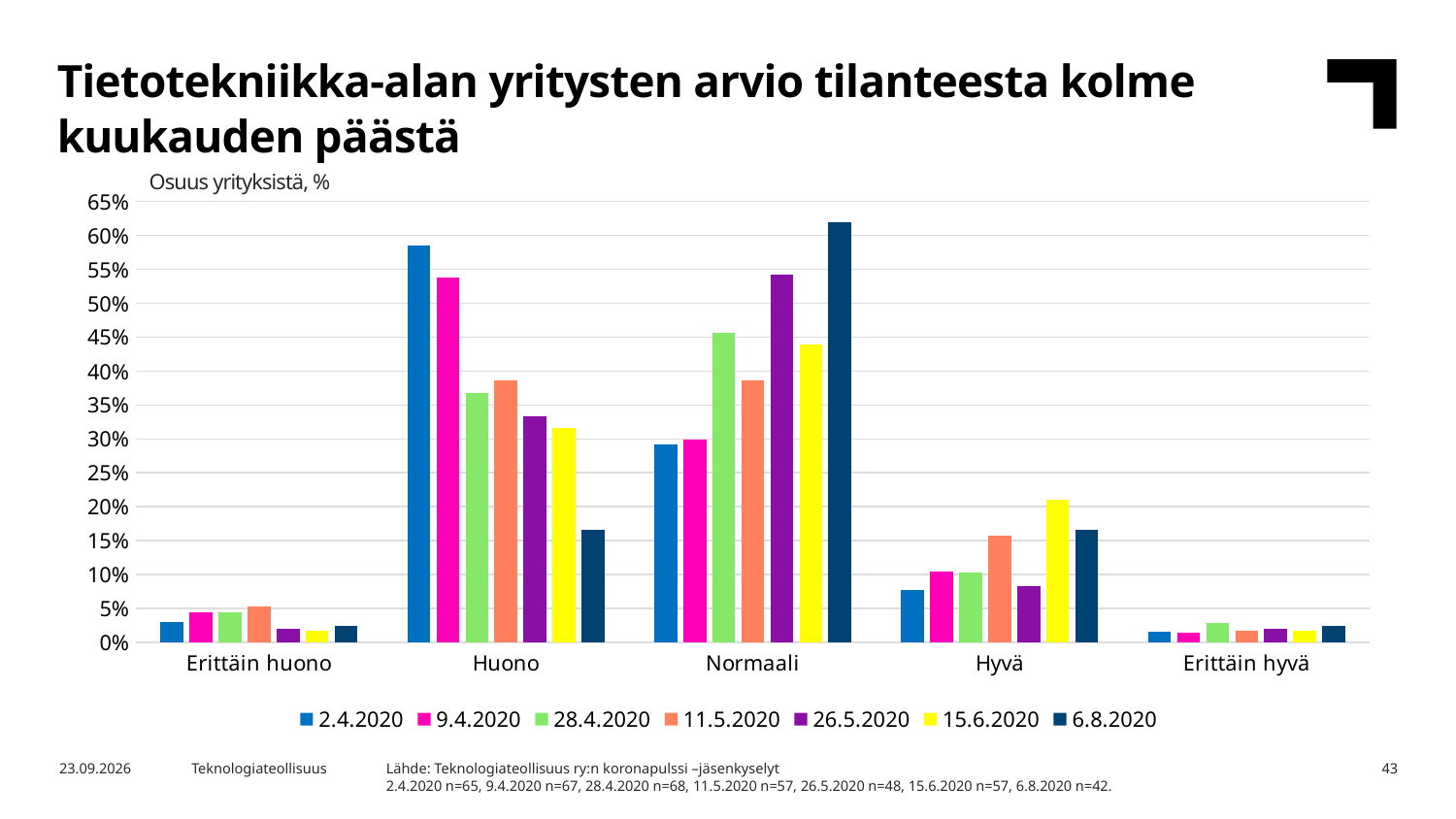
Is the value for 6.8.2020 in the Normaali category greater or less than 60%? greater What label is shown above the vertical axis? Osuus yrityksistä, % Is the value for 2.4.2020 in the Huono category greater or less than 55%? greater How many categories are shown on the x axis? 5 Which series has the lowest bar in the Huono category? 6.8.2020 In the Erittäin huono category, which is larger: the 11.5.2020 bar or the 26.5.2020 bar? 11.5.2020 How many series does the legend list? 7 Which series has the highest bar in the Huono category? 2.4.2020 Which category has the highest bar for the 6.8.2020 series? Normaali Is the value for 15.6.2020 in the Hyvä category greater or less than 15%? greater What kind of chart is shown on the slide? bar chart In the Hyvä category, which is larger: the 15.6.2020 bar or the 11.5.2020 bar? 15.6.2020